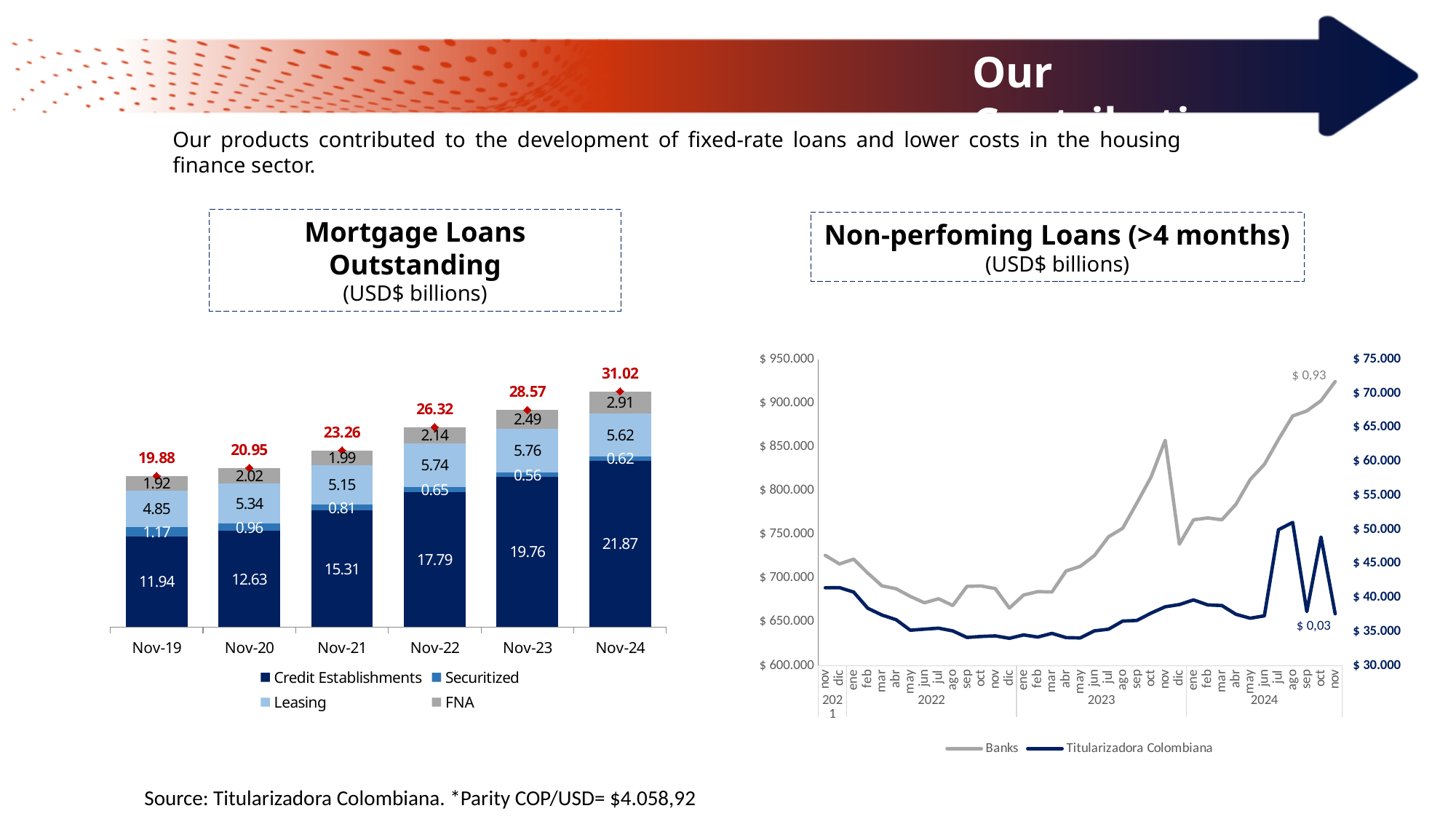
On the Mortgage Loans Outstanding chart, what is the difference between the totals for Nov-24 and Nov-23? 2.45 On the Mortgage Loans Outstanding chart, what is the total value for Nov-24? 31.02 On the Mortgage Loans Outstanding chart, which is larger: the Leasing value for Nov-20 or the Leasing value for Nov-21? Nov-20 On the Non-perfoming Loans (>4 months) chart, what value is labelled at the end of the Banks line? $ 0,93 On the Mortgage Loans Outstanding chart, which year has the highest total? Nov-24 On the Mortgage Loans Outstanding chart, what is the Leasing value for Nov-22? 5.74 On the Mortgage Loans Outstanding chart, what is the FNA value for Nov-19? 1.92 What kind of chart is the Non-perfoming Loans (>4 months) chart? line chart On the Mortgage Loans Outstanding chart, how many series does the legend list? 4 On the Mortgage Loans Outstanding chart, which year has the lowest Securitized value? Nov-23 On the Mortgage Loans Outstanding chart, how many years are shown on the x axis? 6 On the Mortgage Loans Outstanding chart, what is the Credit Establishments value for Nov-21? 15.31